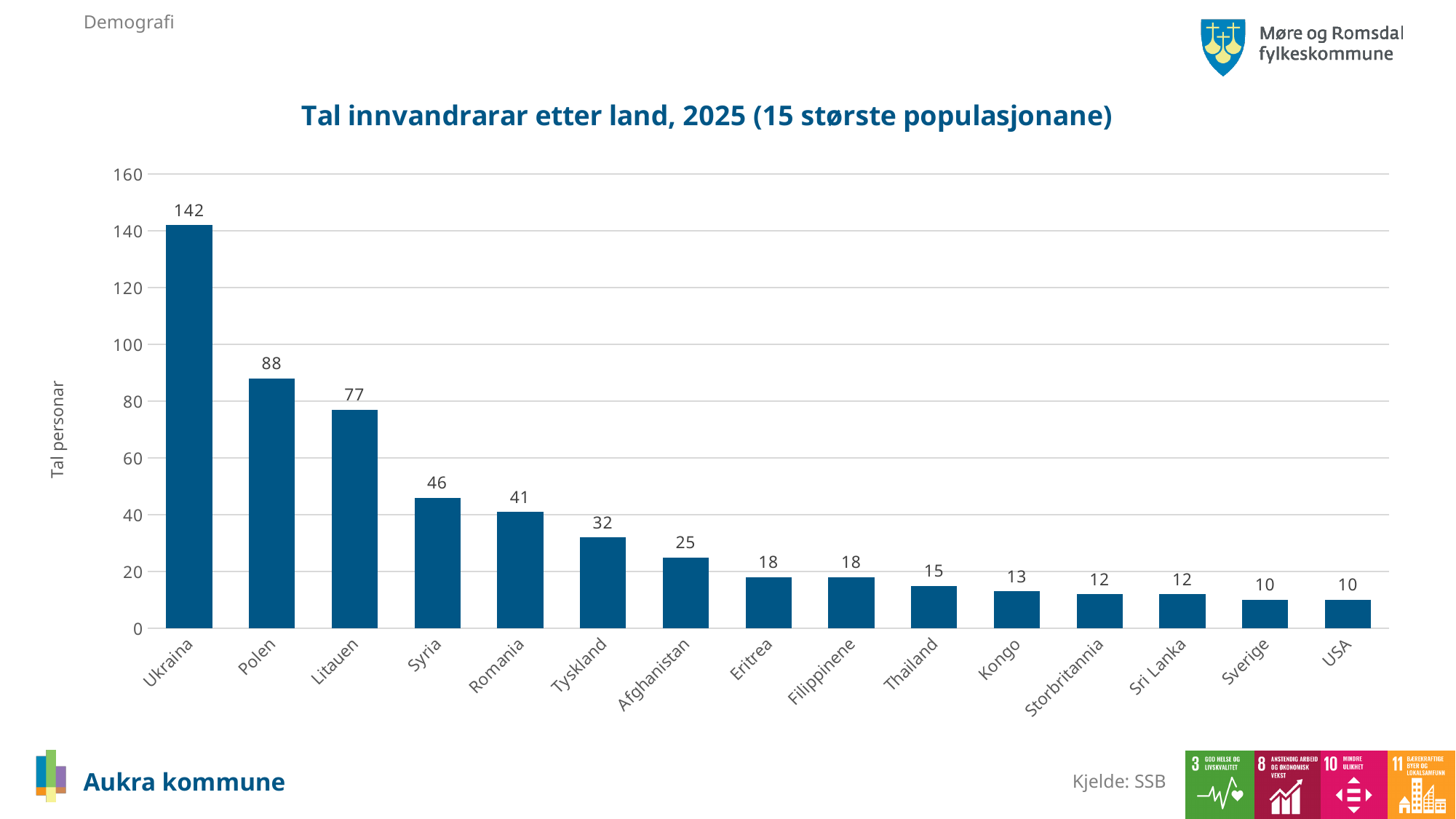
What is the value for Ukraina? 142 Which is larger, the value for Romania or the value for Eritrea? Romania What is the value for Afghanistan? 25 What is the difference between the values for Ukraina and Polen? 54 What is the value for Syria? 46 Which country has the highest value? Ukraina What is the difference between the values for Litauen and Tyskland? 45 What kind of chart is this? bar chart What is the title of the chart? Tal innvandrarar etter land, 2025 (15 største populasjonane) Which country has the lowest value, Sverige or Polen? Sverige Do the values rise or fall from left to right along the x axis? fall How many countries are shown on the x axis? 15